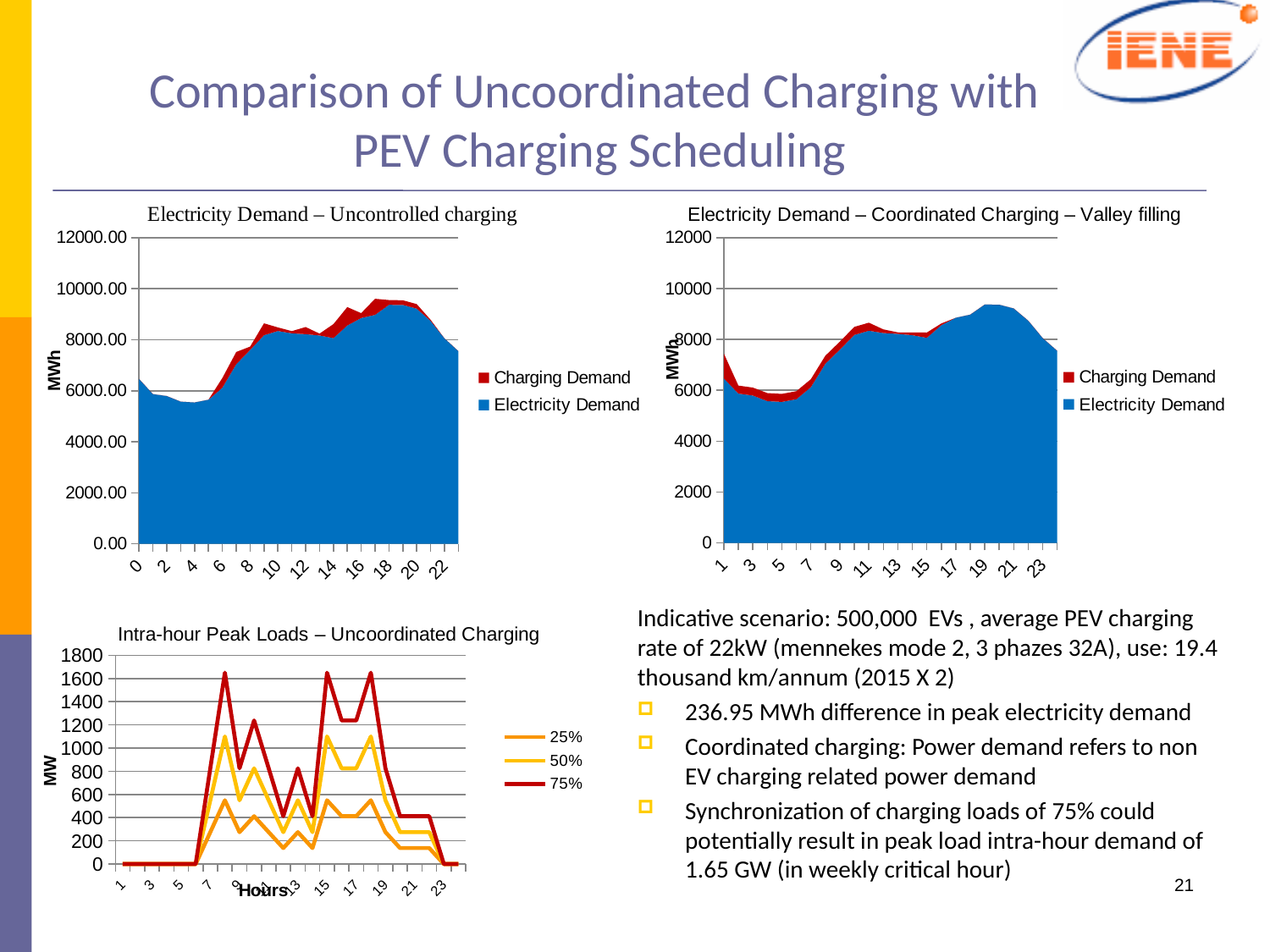
In the 'Intra-hour Peak Loads – Uncoordinated Charging' chart, is the peak value of the 25% series greater or less than 800? less In the 'Electricity Demand – Uncontrolled charging' chart, is the total demand at hour 18 greater or less than 8000.00? greater In the 'Intra-hour Peak Loads – Uncoordinated Charging' chart, which series reaches the highest values? 75% How many series does the legend list in the 'Electricity Demand – Uncontrolled charging' chart? 2 What kind of chart is the 'Intra-hour Peak Loads – Uncoordinated Charging' chart? Line chart In the 'Intra-hour Peak Loads – Uncoordinated Charging' chart, is the peak value of the 75% series greater or less than 1400? greater What is the y-axis label of the 'Electricity Demand – Coordinated Charging – Valley filling' chart? MWh How many series does the legend list in the 'Intra-hour Peak Loads – Uncoordinated Charging' chart? 3 In the 'Electricity Demand – Uncontrolled charging' chart, does the total demand rise or fall from hour 4 to hour 18? rise What is the x-axis label of the 'Intra-hour Peak Loads – Uncoordinated Charging' chart? Hours In the 'Intra-hour Peak Loads – Uncoordinated Charging' chart, which series has the lowest values? 25%